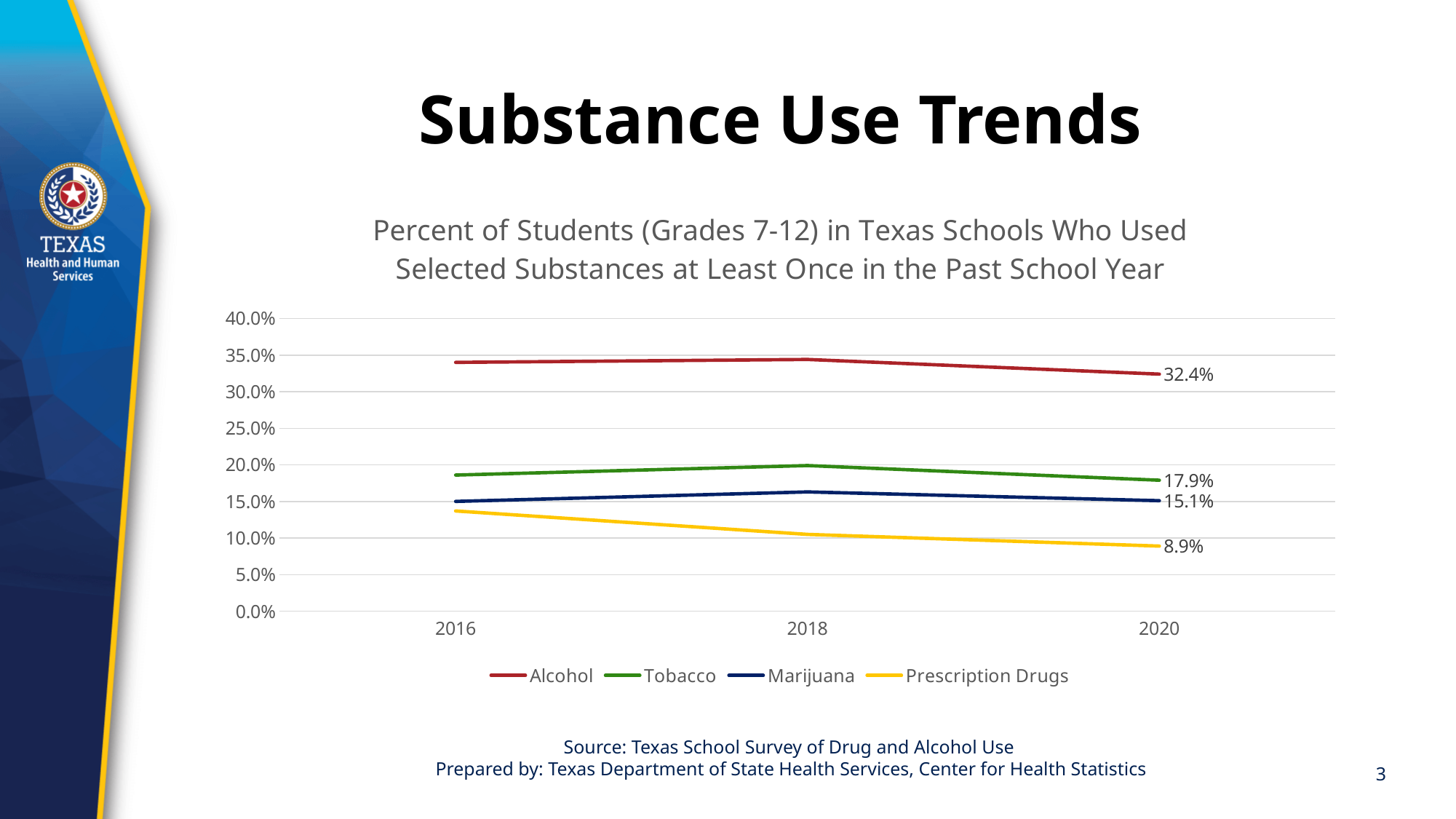
Is the value for alcohol in 2016 greater or less than 30.0%? greater What is the difference between the alcohol and tobacco percentages in 2020? 14.5% What percent of students used prescription drugs in 2020? 8.9% What percent of students used alcohol in 2020? 32.4% Which was higher in 2020, marijuana use or prescription drug use? Marijuana What percent of students used marijuana in 2020? 15.1% Does prescription drug use rise or fall from 2016 to 2020? Fall Which substance had the highest percentage of student use in 2020? Alcohol Which substance had the lowest percentage of student use in 2020? Prescription Drugs What kind of chart is shown on the slide? Line chart How many series does the legend list? 4 What percent of students used tobacco in 2020? 17.9%